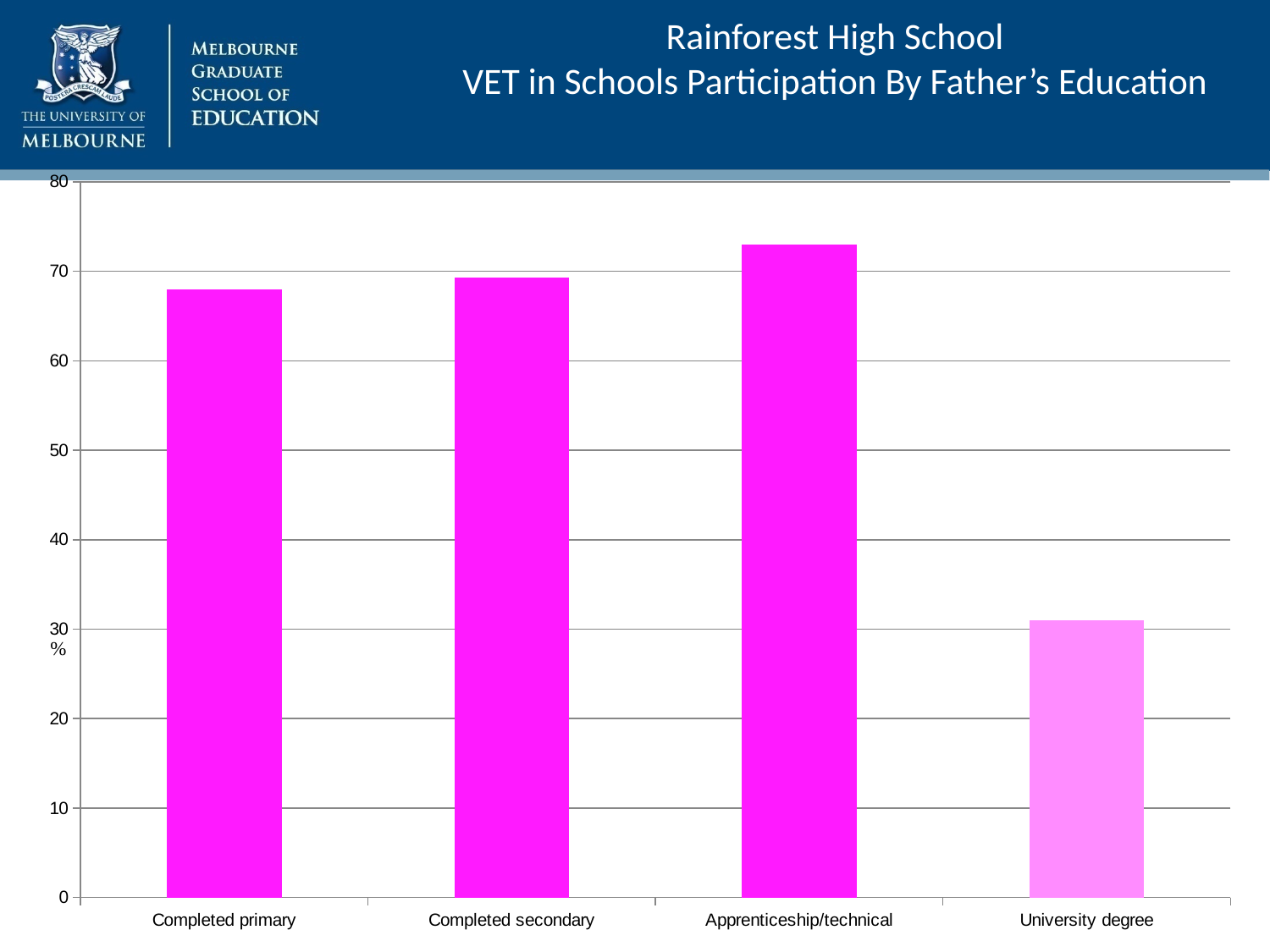
Which father's education category has the highest VET in Schools participation? Apprenticeship/technical What unit is shown on the vertical axis of the chart? % Is the value for Apprenticeship/technical greater or less than 70? greater Does the value rise or fall from Apprenticeship/technical to University degree? fall Which is larger, the value for Apprenticeship/technical or the value for University degree? Apprenticeship/technical How many father's education categories are shown on the x axis? 4 Is the value for University degree greater or less than 40? less Is the value for Completed primary greater or less than 70? less What kind of chart is shown on the slide? bar chart Which father's education category has the lowest VET in Schools participation? University degree Which is larger, the value for Completed primary or the value for Apprenticeship/technical? Apprenticeship/technical